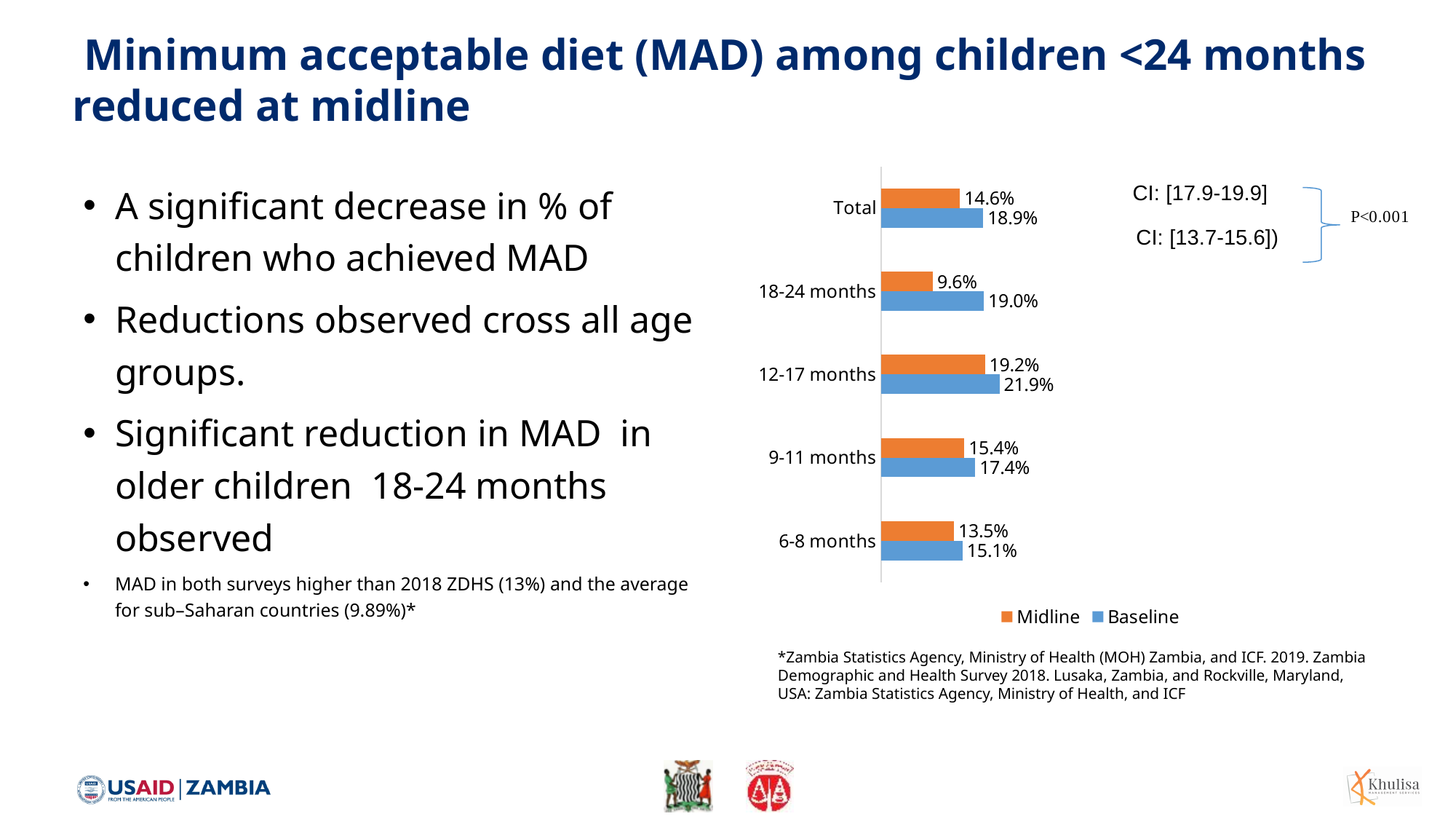
What is the difference between the Baseline and Midline values for children 18-24 months? 9.4% Which age group has the lowest Midline value? 18-24 months What is the Midline value for the Total category? 14.6% What kind of chart is shown on the slide? Bar chart What is the Baseline value for children 6-8 months? 15.1% How many series does the legend list? 2 Which age group has the highest Baseline value? 12-17 months What is the difference between the Baseline and Midline values for the Total category? 4.3% What is the Midline value for children 18-24 months? 9.6% What is the Baseline value for children 12-17 months? 21.9% Which is larger, the Midline value for 9-11 months or the Midline value for 6-8 months? 9-11 months How many categories are shown on the chart? 5